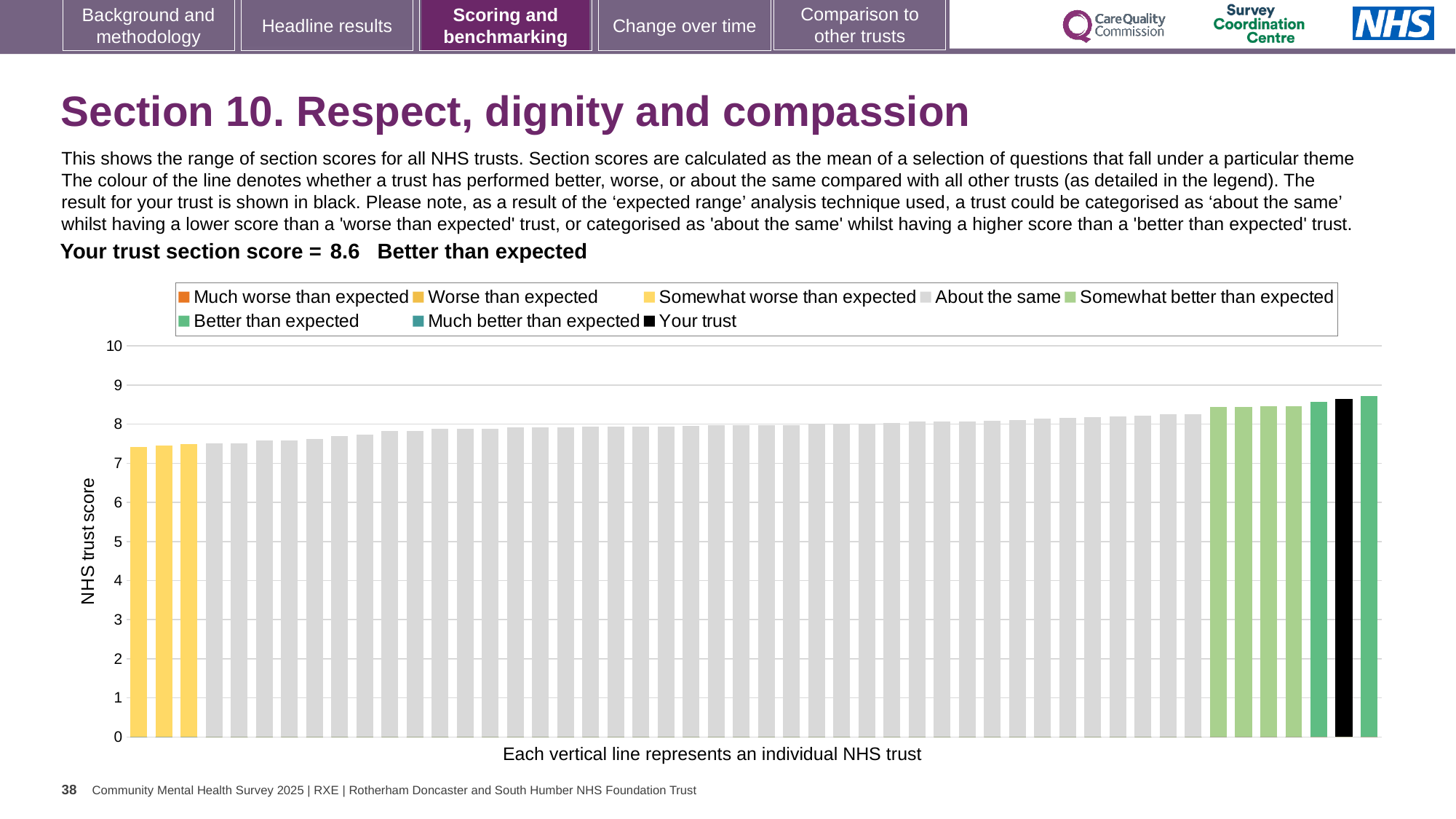
How many entries does the chart legend list? 8 Which category is your trust's section score placed in? Better than expected What is the label on the vertical axis of the chart? NHS trust score What kind of chart is shown on the slide? bar chart How many bars are coloured light green (Somewhat better than expected)? 4 How many bars are coloured yellow (Somewhat worse than expected)? 3 Is the value of the black bar (your trust) greater or less than 8? greater Is the value of the leftmost (lowest) bar greater or less than 8? less Is the value of the leftmost (lowest) bar greater or less than 7? greater What is the section score for your trust shown on the slide? 8.6 Do the bar values rise or fall from left to right along the x axis? rise What colour is used for the bar representing your trust? black